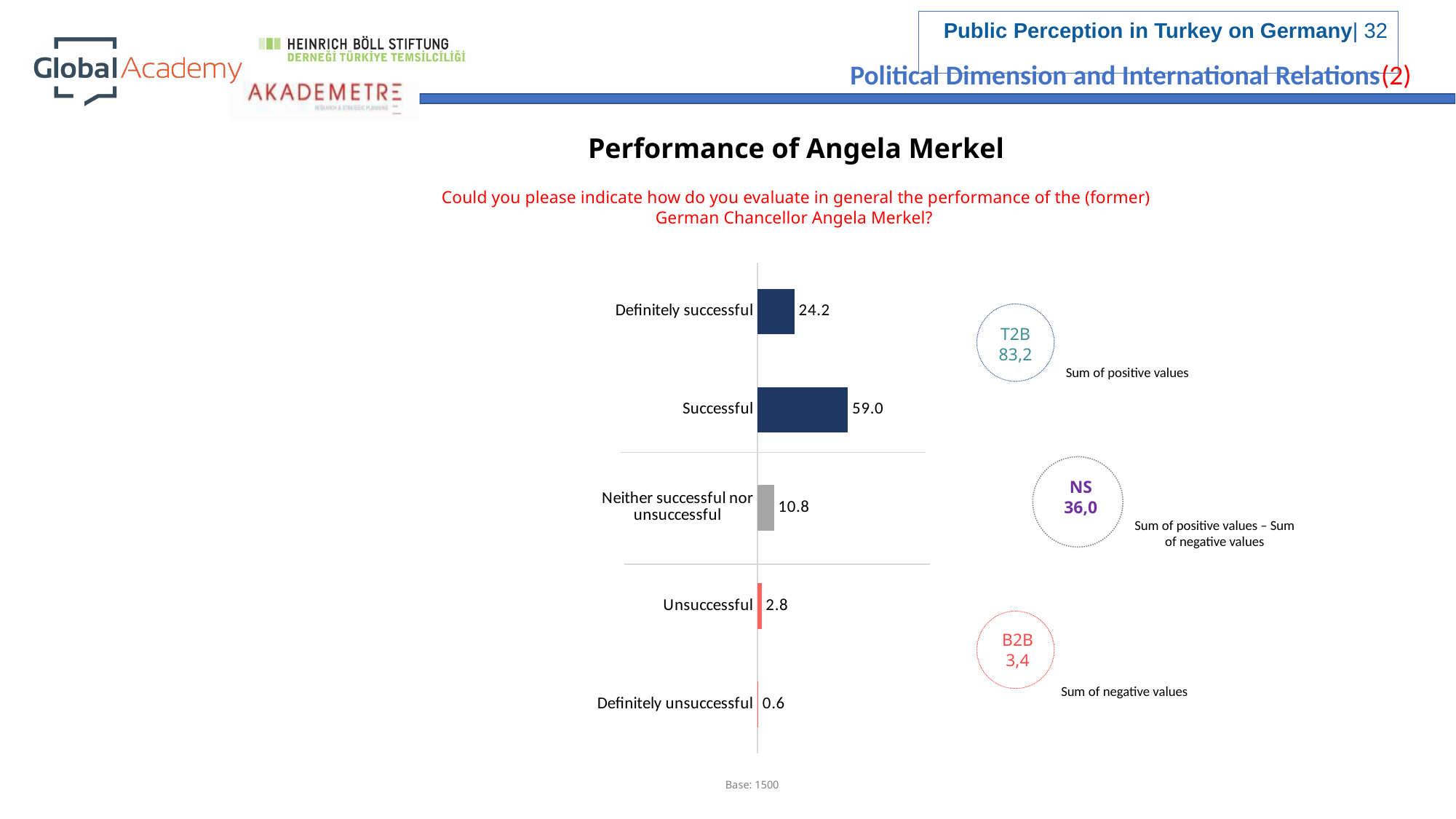
What is the value for "Definitely unsuccessful"? 0.6 What is the value for "Neither successful nor unsuccessful"? 10.8 Which category has the lowest value? Definitely unsuccessful What kind of chart is shown on the slide? Bar chart What is the value for "Definitely successful"? 24.2 What is the T2B (sum of positive values) shown next to the chart? 83,2 What is the value for "Successful"? 59.0 Which category has the highest value? Successful How many categories are shown in the chart? 5 What is the title of the chart? Performance of Angela Merkel What is the difference between the values for "Successful" and "Definitely successful"? 34.8 Which is larger, the value for "Unsuccessful" or the value for "Neither successful nor unsuccessful"? Neither successful nor unsuccessful